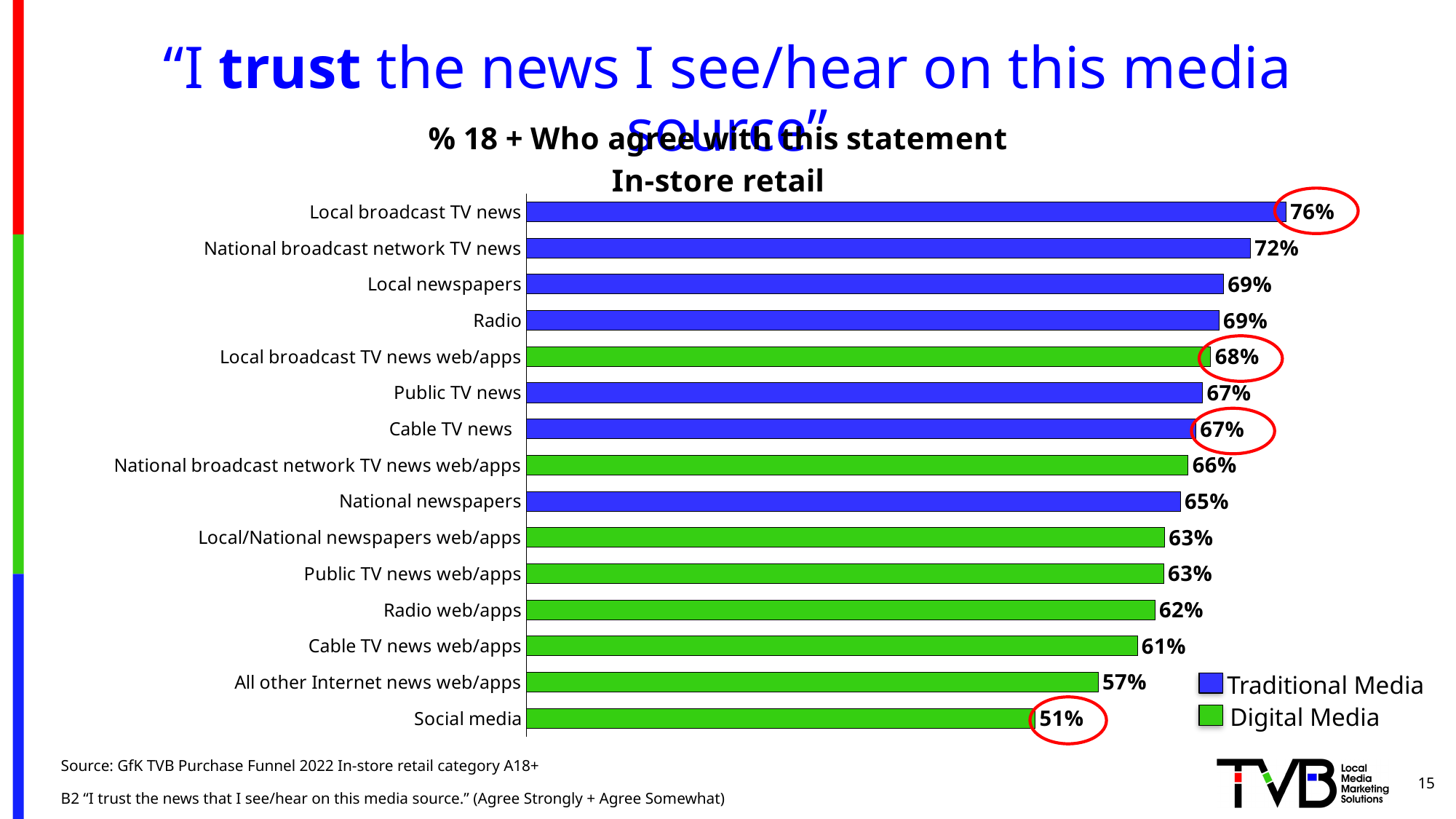
How many media sources are shown in the chart? 15 How many series does the legend list? 2 What is the value for Local broadcast TV news web/apps? 68% What is the difference between National broadcast network TV news and National broadcast network TV news web/apps? 6 percentage points Which media source has the lowest percentage? Social media What kind of chart is shown on the slide? Bar chart What is the value for Social media? 51% What percentage agree with the statement for Local broadcast TV news? 76% What is the difference between Local broadcast TV news and Social media? 25 percentage points Which is larger, the value for Cable TV news or the value for Cable TV news web/apps? Cable TV news Which media source has the highest percentage? Local broadcast TV news Which legend entry is shown in green? Digital Media